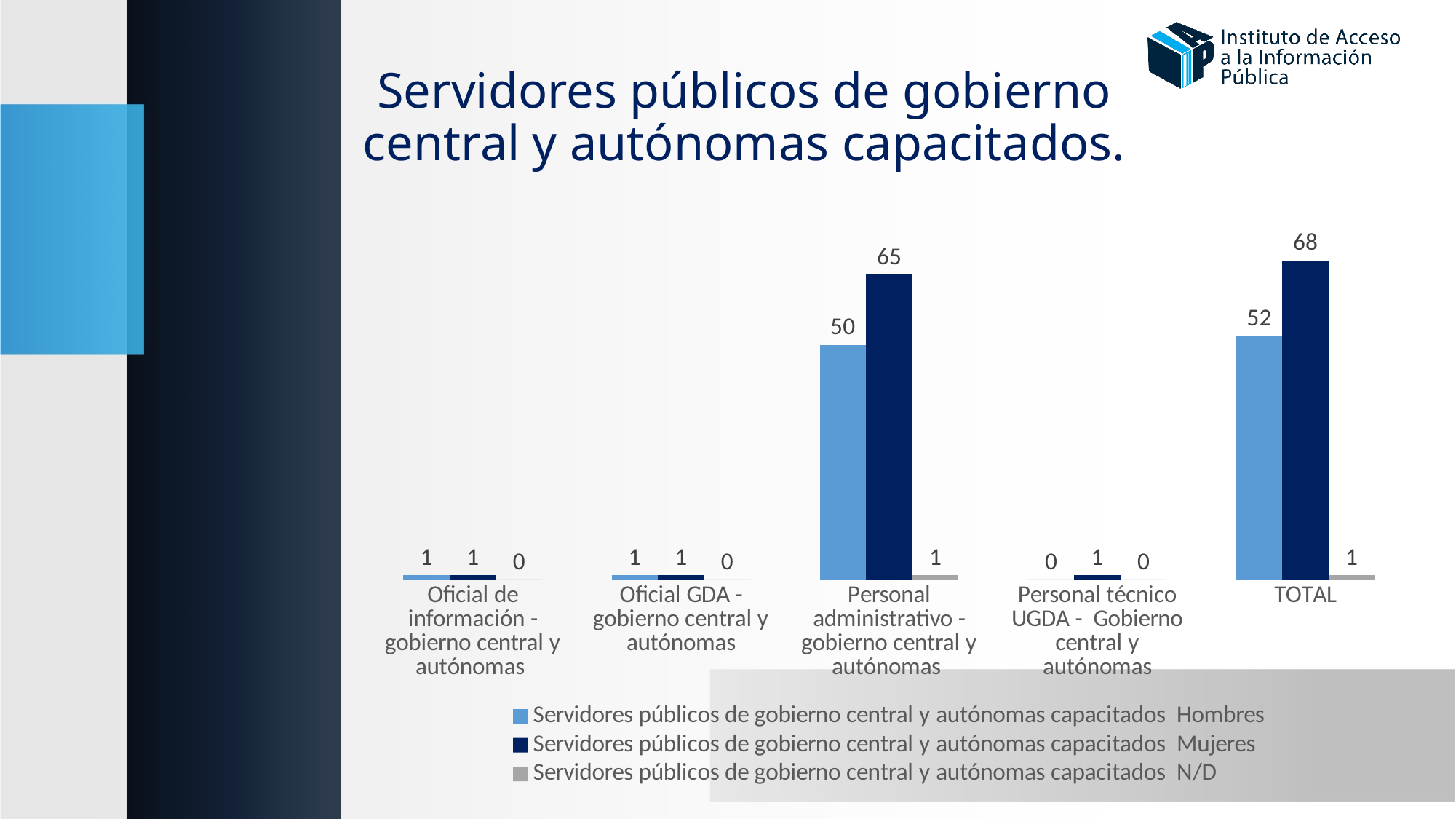
What is the difference between the Mujeres and Hombres values for TOTAL? 16 What is the difference between the Mujeres and Hombres values for Personal administrativo - gobierno central y autónomas? 15 Which category has the highest Mujeres value? TOTAL What kind of chart is shown on the slide? Bar chart What is the Mujeres value for Personal administrativo - gobierno central y autónomas? 65 How many categories are shown on the x axis? 5 What is the N/D value for Personal administrativo - gobierno central y autónomas? 1 How many series does the legend list? 3 What colour are the Mujeres bars? Dark navy blue What is the Hombres value for Personal técnico UGDA - Gobierno central y autónomas? 0 For Personal administrativo - gobierno central y autónomas, which is larger: the Hombres value or the Mujeres value? Mujeres What is the Hombres value for TOTAL? 52